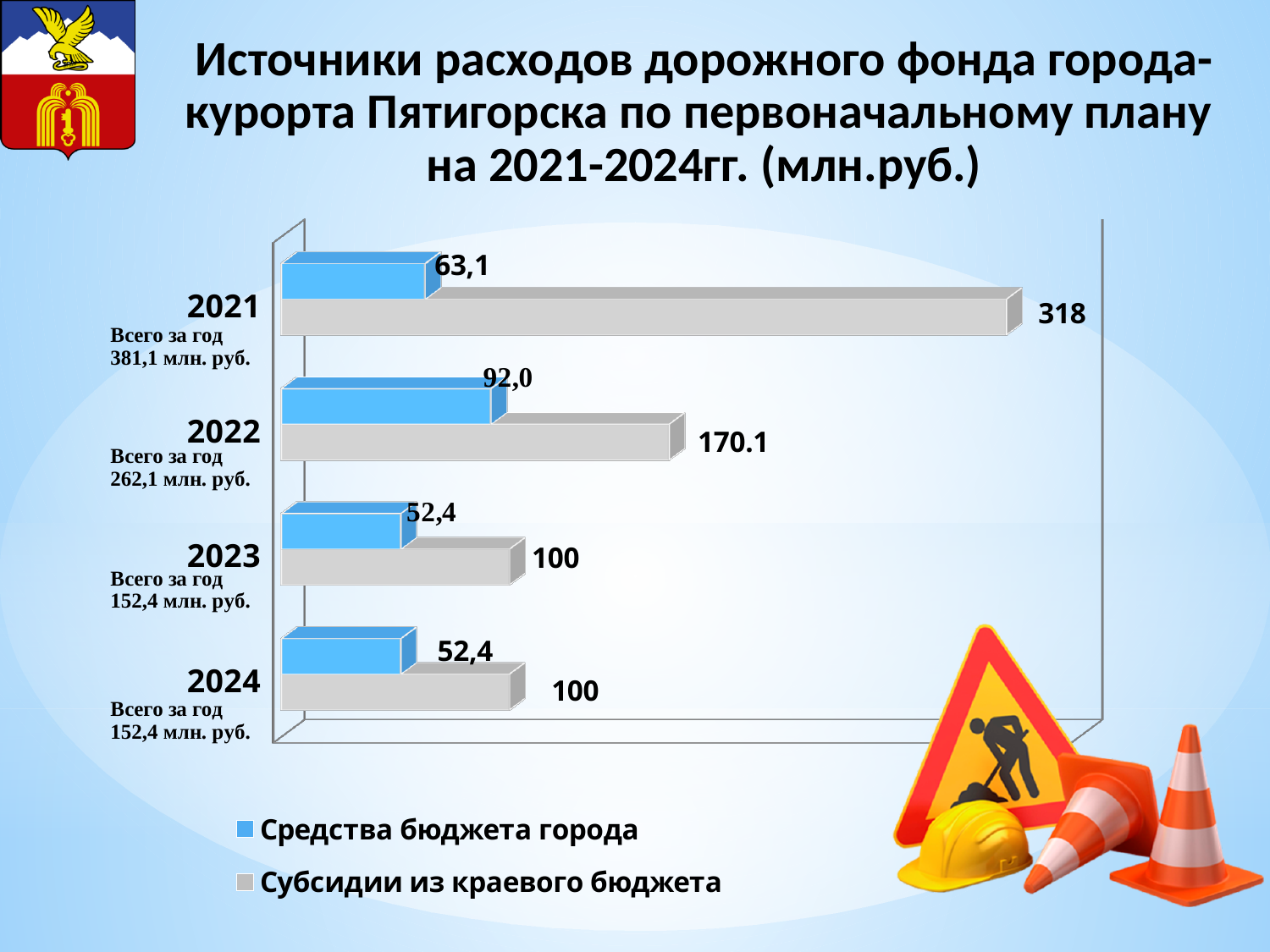
Does Субсидии из краевого бюджета rise or fall from 2021 to 2024? Fall What is the value of Средства бюджета города for 2022? 92,0 In which year is Субсидии из краевого бюджета highest? 2021 How many years are shown on the chart? 4 In which year is Средства бюджета города highest? 2022 What is the value of Субсидии из краевого бюджета for 2022? 170.1 What is the value of Субсидии из краевого бюджета for 2024? 100 What is the difference between Субсидии из краевого бюджета in 2021 and in 2022? 147.9 Which is larger in 2023: Средства бюджета города or Субсидии из краевого бюджета? Субсидии из краевого бюджета How many series does the legend list? 2 What kind of chart is shown on the slide? Bar chart What is the value of Средства бюджета города for 2021? 63,1